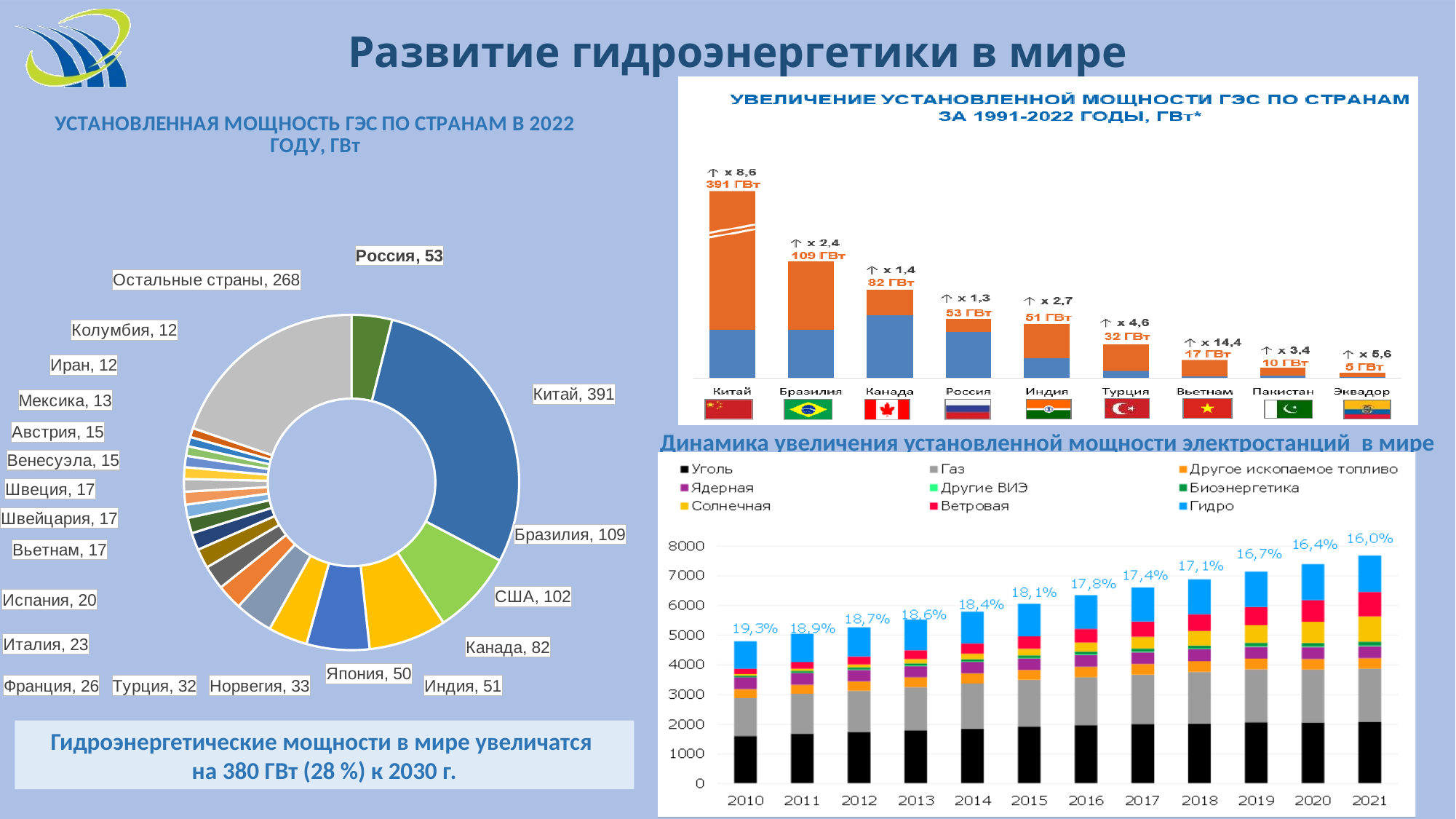
In the donut chart on the left, what is the difference between the values for Бразилия and США? 7 In the top-right chart 'УВЕЛИЧЕНИЕ УСТАНОВЛЕННОЙ МОЩНОСТИ ГЭС ПО СТРАНАМ', which country has the lowest value? Эквадор In the donut chart on the left, what is the value for Китай? 391 In the bottom-right chart 'Динамика увеличения установленной мощности электростанций в мире', do the percentage labels above the bars rise or fall from 2010 to 2021? fall What kind of chart is the top-right chart titled 'УВЕЛИЧЕНИЕ УСТАНОВЛЕННОЙ МОЩНОСТИ ГЭС ПО СТРАНАМ ЗА 1991-2022 ГОДЫ, ГВт*'? bar chart How many series does the legend list in the bottom-right chart 'Динамика увеличения установленной мощности электростанций в мире'? 9 In the top-right chart 'УВЕЛИЧЕНИЕ УСТАНОВЛЕННОЙ МОЩНОСТИ ГЭС ПО СТРАНАМ', what value is labelled for Вьетнам? 17 ГВт In the donut chart on the left, which is larger: the value for Канада or the value for Индия? Канада How many countries are shown in the top-right chart 'УВЕЛИЧЕНИЕ УСТАНОВЛЕННОЙ МОЩНОСТИ ГЭС ПО СТРАНАМ ЗА 1991-2022 ГОДЫ'? 9 In the bottom-right chart 'Динамика увеличения установленной мощности электростанций в мире', what percentage is labelled above the 2010 bar? 19,3% In the bottom-right chart 'Динамика увеличения установленной мощности электростанций в мире', is the total height of the 2021 bar greater or less than 7000? greater In the donut chart on the left, what is the value for Россия? 53